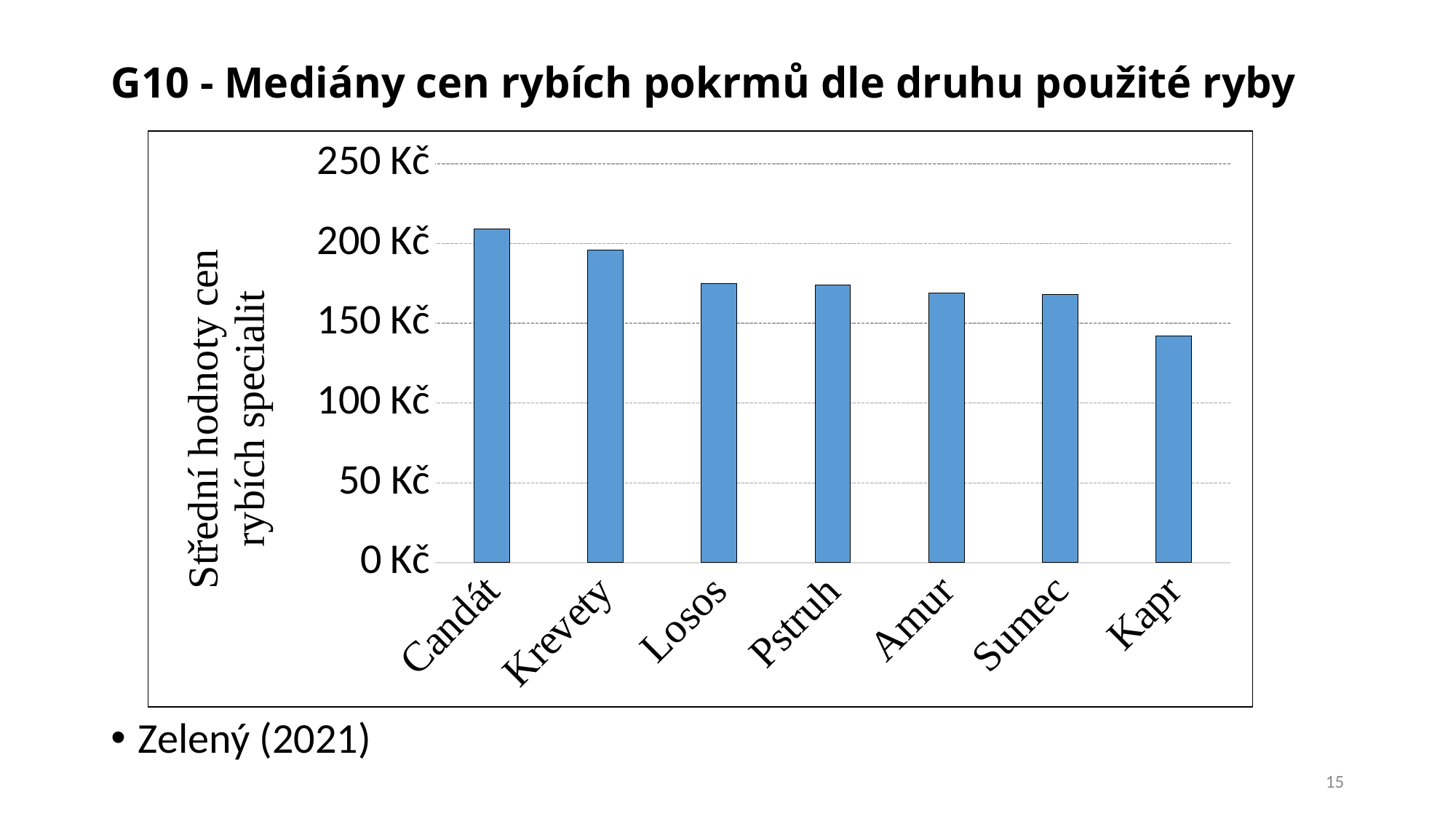
Which has a higher median price, Krevety or Losos? Krevety Which fish type has the lowest median price? Kapr What kind of chart is shown on the slide? bar chart Is the value for Krevety greater or less than 200 Kč? less Which has a higher median price, Sumec or Kapr? Sumec How many fish types (categories) are shown on the x axis? 7 Is the value for Losos greater or less than 150 Kč? greater Is the value for Candát greater or less than 200 Kč? greater What is the title of the vertical axis? Střední hodnoty cen rybích specialit Do the values rise or fall from left to right along the x axis? fall Which fish type has the highest median price? Candát